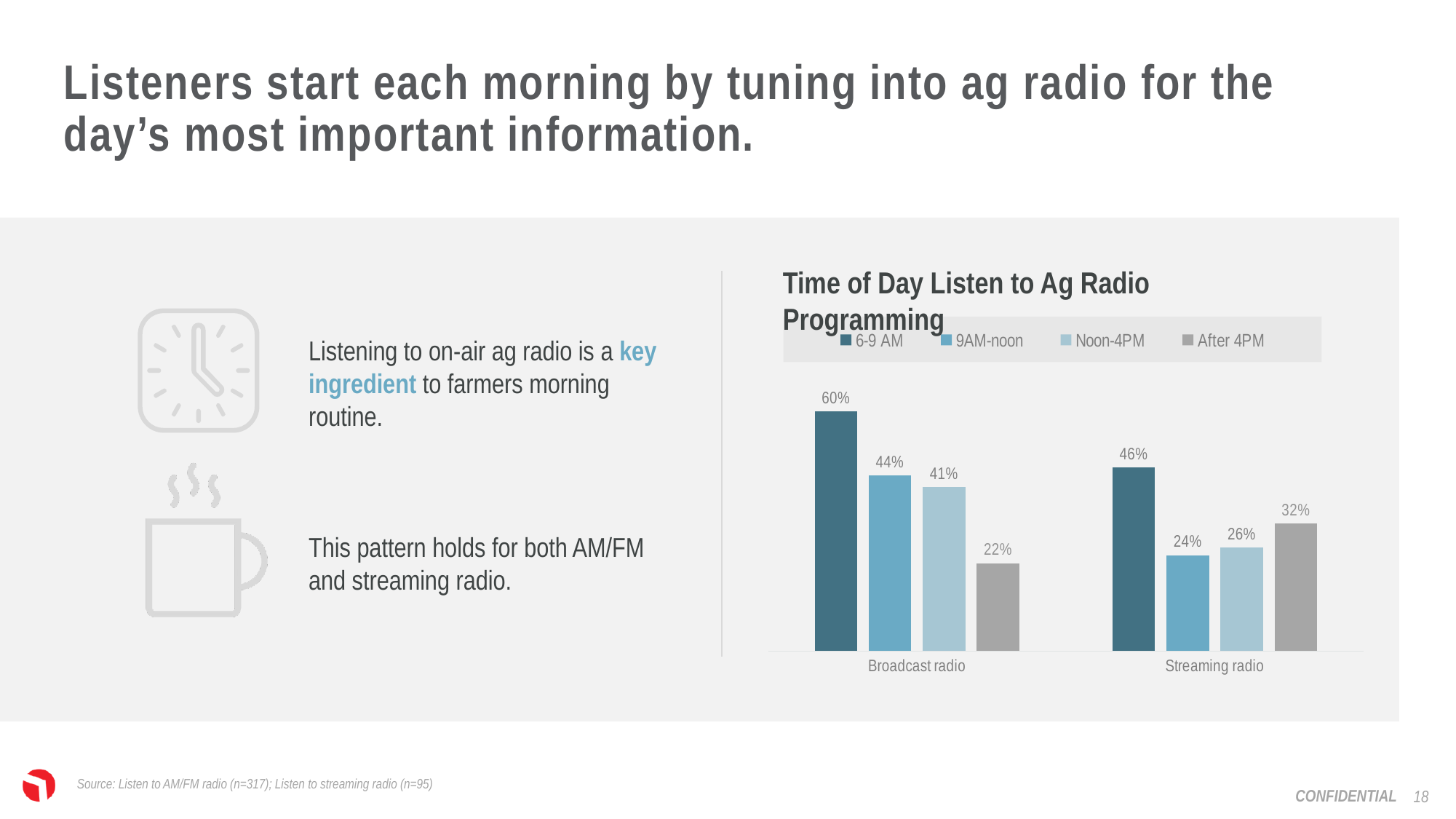
What is the value for Noon-4PM for Broadcast radio? 41% What is the difference between the 6-9 AM values for Broadcast radio and Streaming radio? 14 percentage points Which time-of-day series has the lowest value for Broadcast radio? After 4PM What is the title of the chart? Time of Day Listen to Ag Radio Programming Which time-of-day series has the highest value for Streaming radio? 6-9 AM Which is larger: the After 4PM value for Broadcast radio or for Streaming radio? Streaming radio How many categories are shown on the x axis? 2 What kind of chart is shown on the slide? Bar chart How many series does the legend list? 4 What is the value for After 4PM for Streaming radio? 32% What is the value for 6-9 AM for Broadcast radio? 60% What is the value for 9AM-noon for Streaming radio? 24%